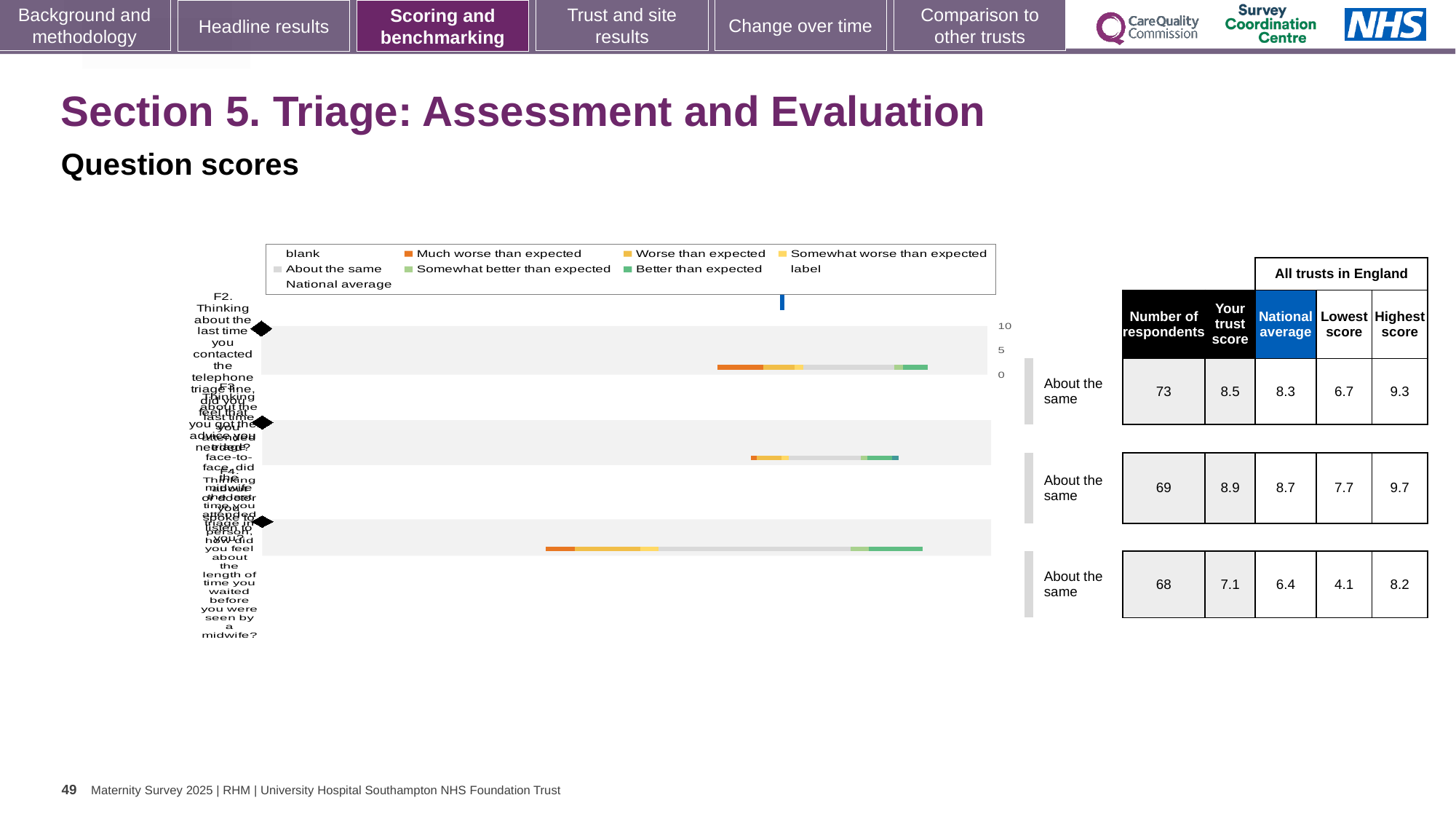
What kind of chart is shown on the slide? bar chart In the table next to the chart, what is the number of respondents for the second (middle) row? 69 In the table next to the chart, what is the highest score for the second (middle) row? 9.7 In the table next to the chart, what is the 'Your trust score' for the first (top) row? 8.5 In the table next to the chart, what is the lowest score for the third (bottom) row? 4.1 What benchmark category is shown to the right of each bar in the chart? About the same Which row has the highest 'Your trust score' in the table next to the chart? the second (middle) row For the first (top) row, which is larger: 'Your trust score' or the national average? Your trust score How many question rows (bars) does the chart show? 3 For the third (bottom) row, what is the difference between 'Your trust score' and the national average? 0.7 In the table next to the chart, what is the national average for the first (top) row? 8.3 Which row has the lowest national average in the table next to the chart? the third (bottom) row